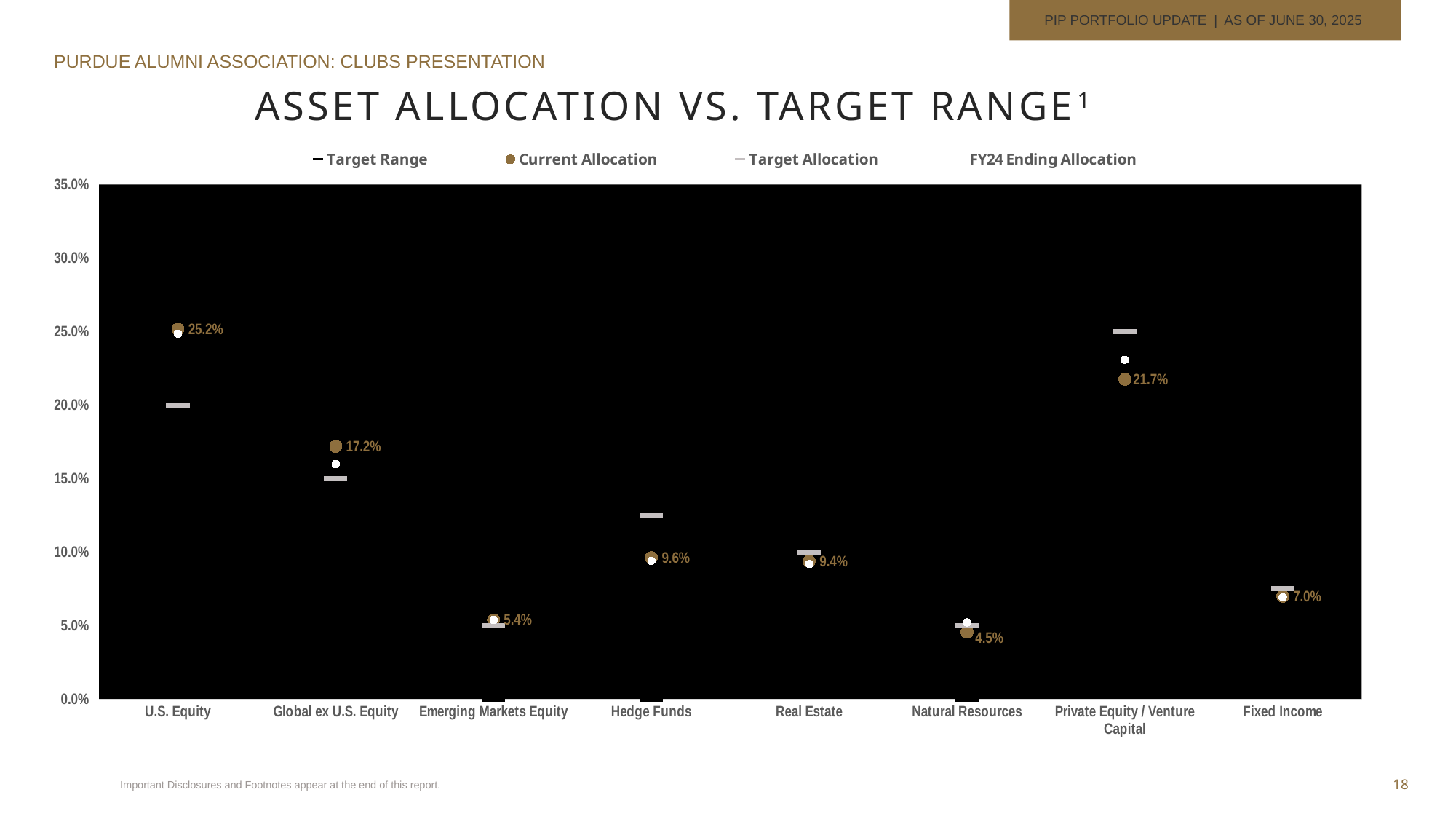
How many asset classes are shown on the x axis? 8 Which asset class has the highest Current Allocation? U.S. Equity What is the Current Allocation for Private Equity / Venture Capital? 21.7% Which has a larger Current Allocation, Global ex U.S. Equity or Emerging Markets Equity? Global ex U.S. Equity What is the Current Allocation for Natural Resources? 4.5% Is the Target Allocation for Hedge Funds greater or less than 10.0%? greater What is the Current Allocation for U.S. Equity? 25.2% What is the difference between the Current Allocation for U.S. Equity and for Private Equity / Venture Capital? 3.5 percentage points What is the Current Allocation for Fixed Income? 7.0% How many series does the legend list? 4 Which asset class has the lowest Current Allocation? Natural Resources What is the title of the chart? Asset Allocation vs. Target Range